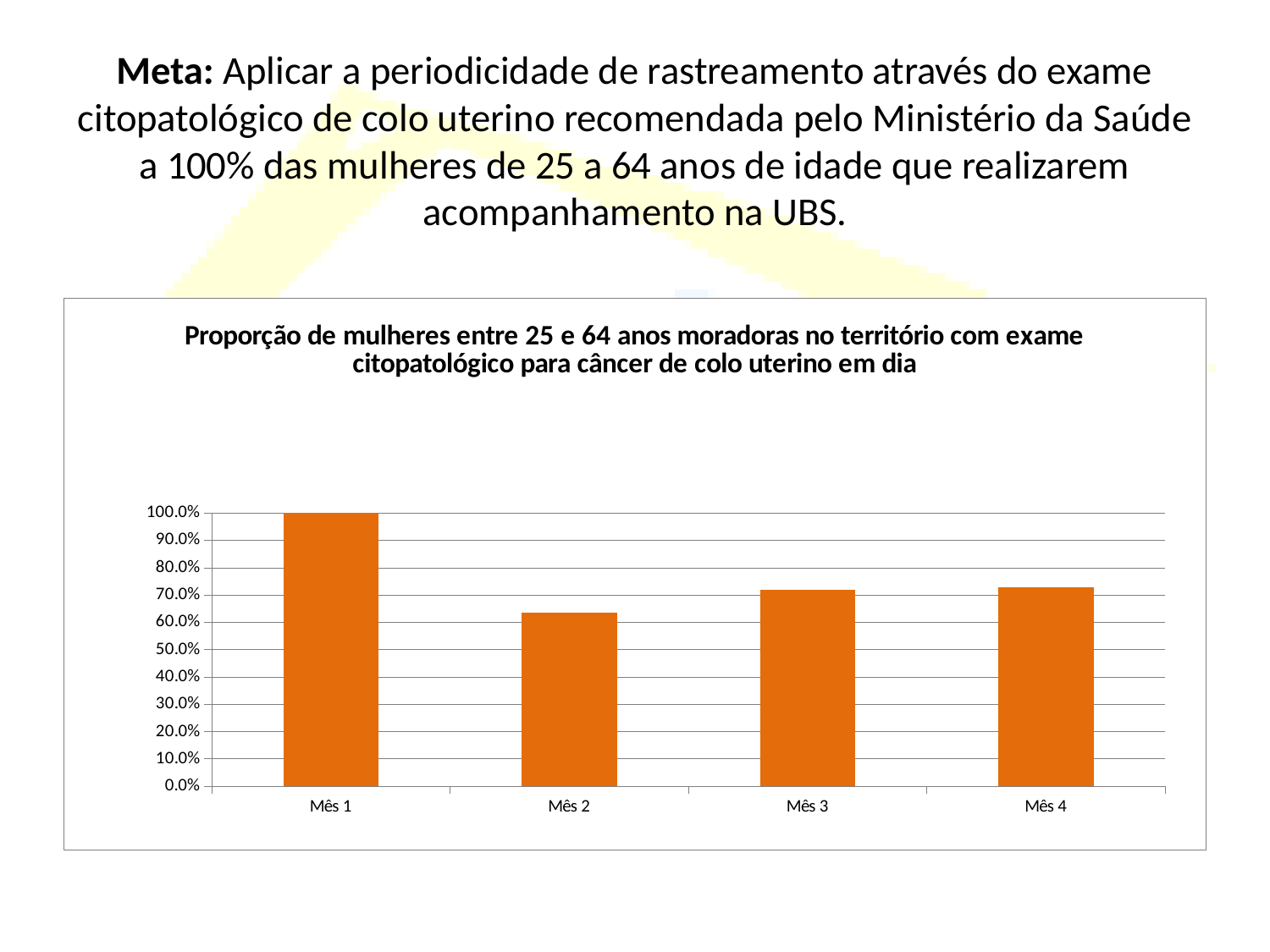
Is the value for Mês 3 greater or less than 80.0%? less Is the value for Mês 2 greater or less than 50.0%? greater Is the value for Mês 2 greater or less than 70.0%? less Which month has the lowest proportion of women with an up-to-date cytopathological exam? Mês 2 Which is larger, the value for Mês 2 or the value for Mês 3? Mês 3 What is the value for Mês 1? 100.0% Which is larger, the value for Mês 1 or the value for Mês 2? Mês 1 What is the title of the chart? Proporção de mulheres entre 25 e 64 anos moradoras no território com exame citopatológico para câncer de colo uterino em dia Which month has the highest proportion of women with an up-to-date cytopathological exam? Mês 1 How many months (categories) are plotted on the chart? 4 What kind of chart is shown on the slide? bar chart